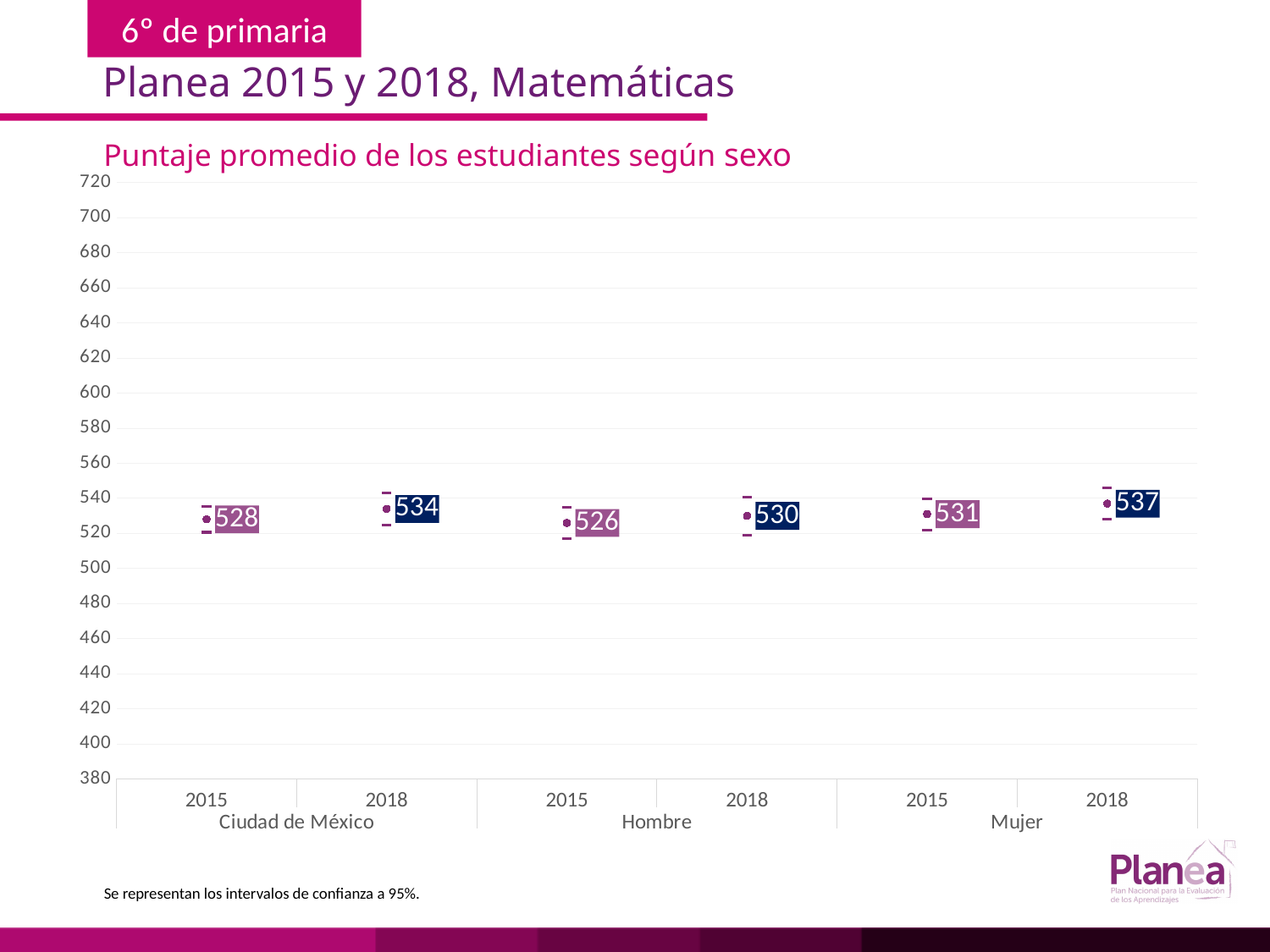
How many data points are plotted on the chart? 6 What is the average score for Mujer in 2015? 531 Which group and year has the highest average score? Mujer 2018 Do the average scores rise or fall from 2015 to 2018 for each group? rise What is the difference between the Mujer and Hombre average scores in 2018? 7 What is the average score for Ciudad de México in 2018? 534 Which group and year has the lowest average score? Hombre 2015 By how many points did the average score for Ciudad de México change from 2015 to 2018? 6 What is the average score for Mujer in 2018? 537 Is the 2015 score for Hombre greater or less than 540? less Which is larger, the 2018 score for Hombre or the 2018 score for Mujer? Mujer What is the average score for Hombre in 2015? 526